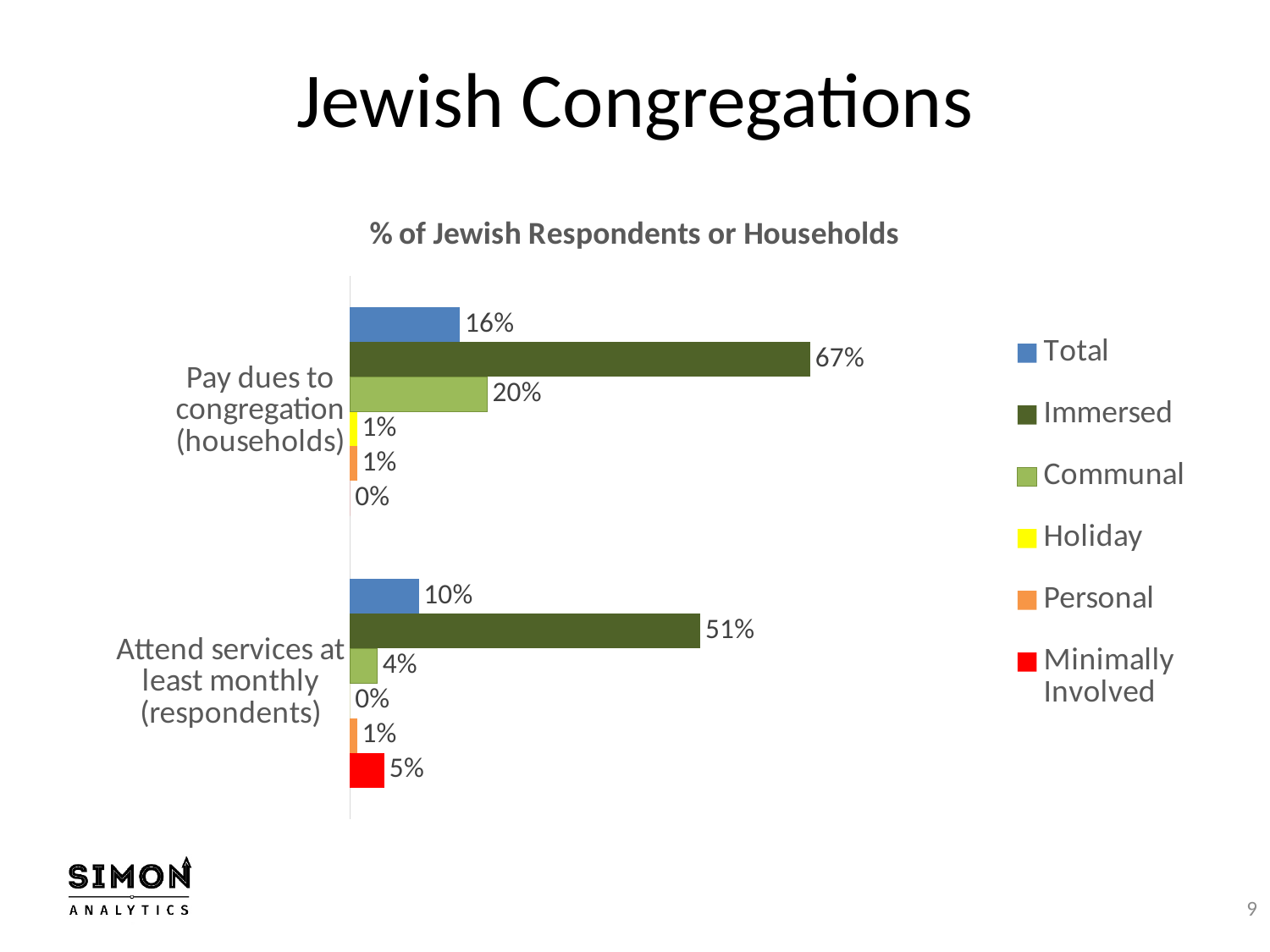
What is the Communal value for 'Pay dues to congregation (households)'? 20% What is the Immersed value for 'Pay dues to congregation (households)'? 67% Which series is shown in red in the legend? Minimally Involved What kind of chart is shown on the slide? Bar chart What is the title of the chart? % of Jewish Respondents or Households How many categories are shown on the chart? 2 What is the Minimally Involved value for 'Attend services at least monthly (respondents)'? 5% What is the Total value for 'Attend services at least monthly (respondents)'? 10% What is the difference between the Immersed values for 'Pay dues to congregation (households)' and 'Attend services at least monthly (respondents)'? 16% How many series does the legend list? 6 Which is larger: the Communal value for 'Pay dues to congregation (households)' or the Communal value for 'Attend services at least monthly (respondents)'? Pay dues to congregation (households) Which series has the highest value for 'Attend services at least monthly (respondents)'? Immersed